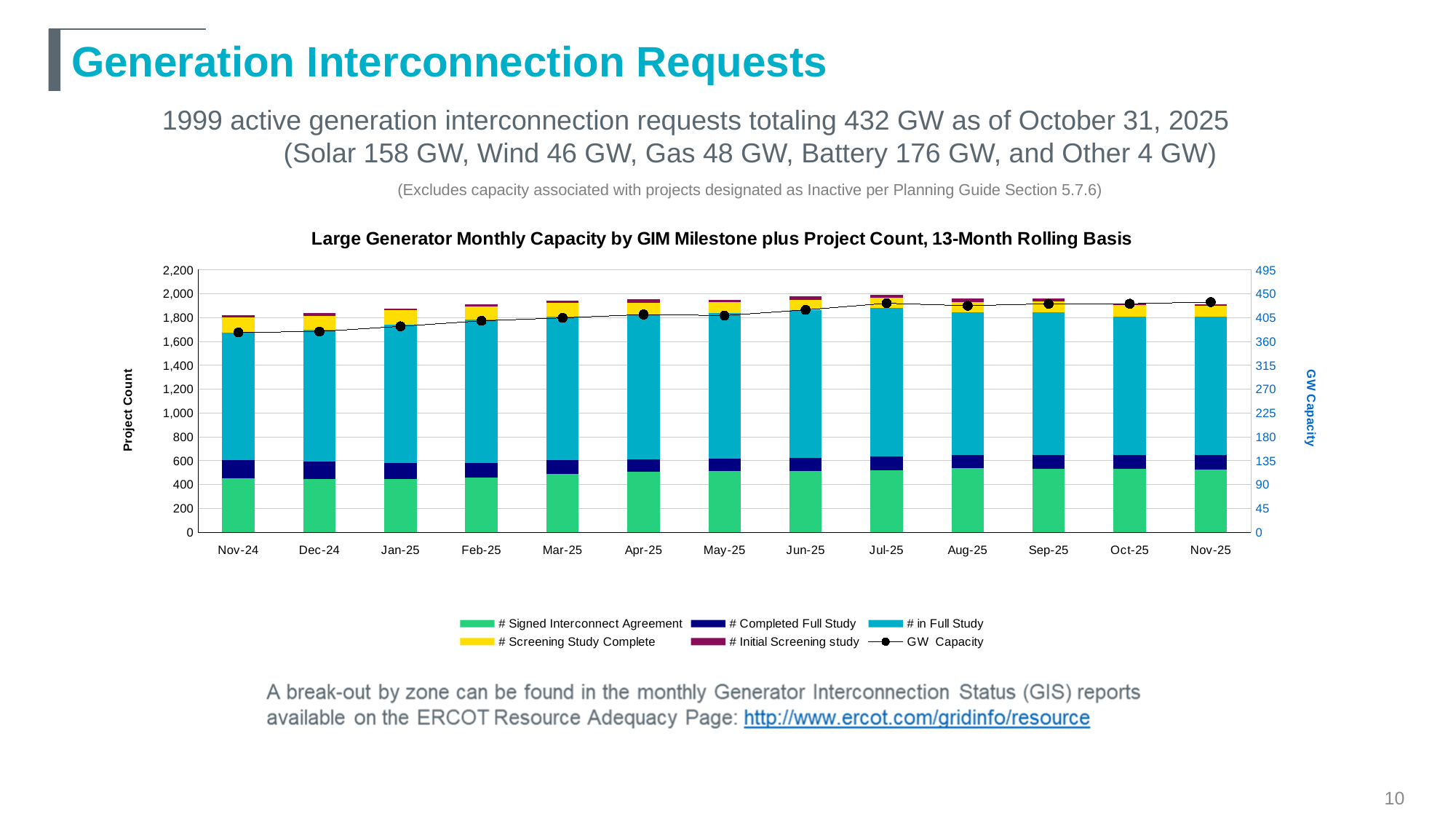
Is the GW Capacity value for Nov-25 greater or less than 405? greater Is the total project count bar for Nov-24 greater or less than 2,000? less Is the GW Capacity value for Nov-24 greater or less than 405? less How many months are shown on the x axis of the chart? 13 How many series does the chart's legend list? 6 What kind of chart is shown on the slide? Stacked bar chart with a line What is the label of the right-hand vertical axis? GW Capacity What is the title of the chart? Large Generator Monthly Capacity by GIM Milestone plus Project Count, 13-Month Rolling Basis Does the GW Capacity line rise or fall from Nov-24 to Nov-25? rise Which month has the larger total project count bar, Nov-24 or Jul-25? Jul-25